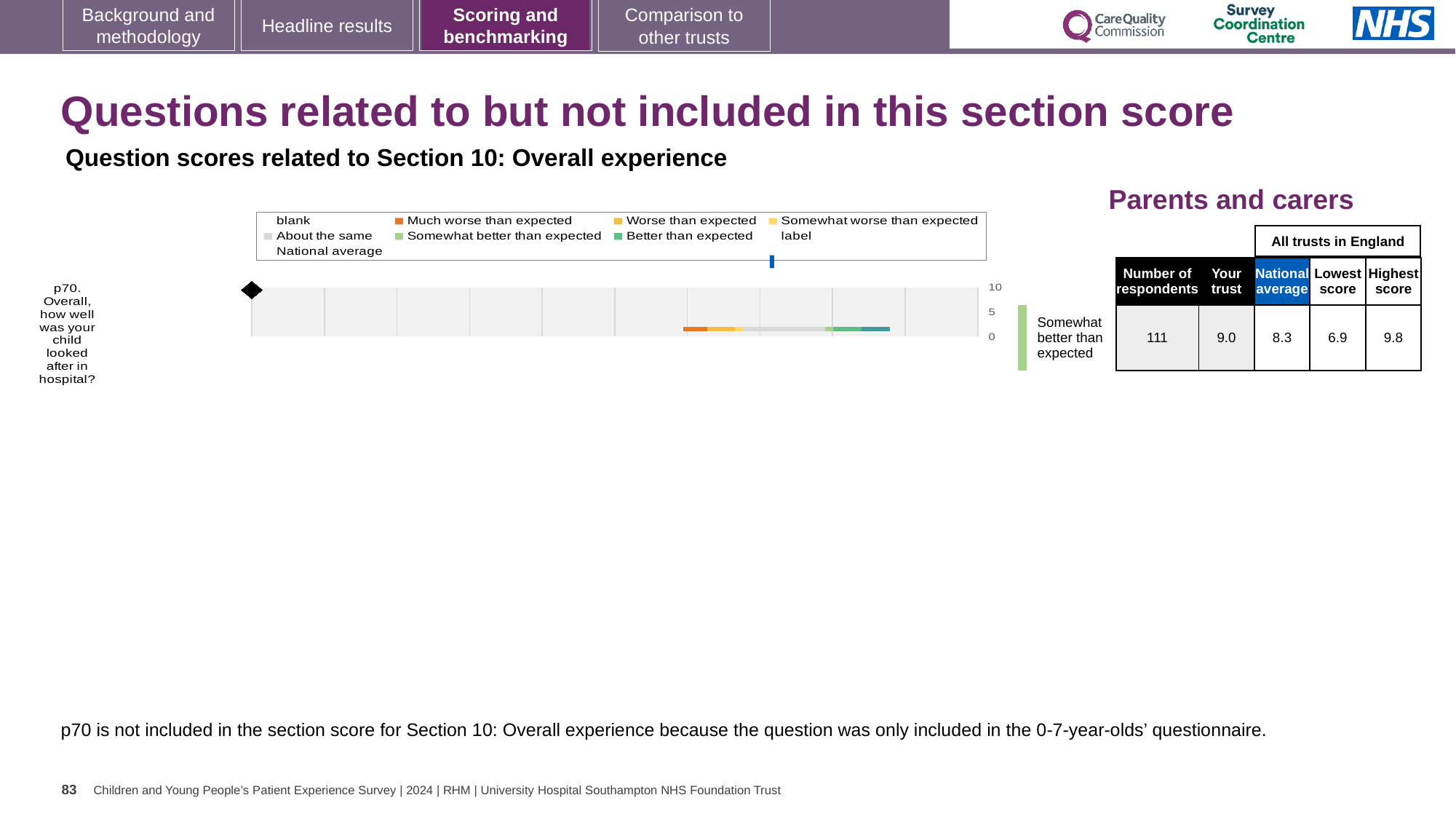
How many survey questions are plotted in the chart? 1 According to the table beside the chart, what is the lowest score among all trusts in England for p70? 6.9 What kind of chart is shown for question p70 on the slide? bar chart Which question is plotted in the chart? p70. Overall, how well was your child looked after in hospital? What benchmark category is shown next to the chart for p70? Somewhat better than expected According to the table beside the chart, what is the 'Your trust' score for p70? 9.0 What is the difference between the highest score and the lowest score for p70 in the table? 2.9 How many respondents answered question p70 according to the table? 111 According to the table beside the chart, what is the national average score for p70? 8.3 According to the table beside the chart, what is the highest score among all trusts in England for p70? 9.8 Which is larger for p70: the 'Your trust' score or the national average? Your trust